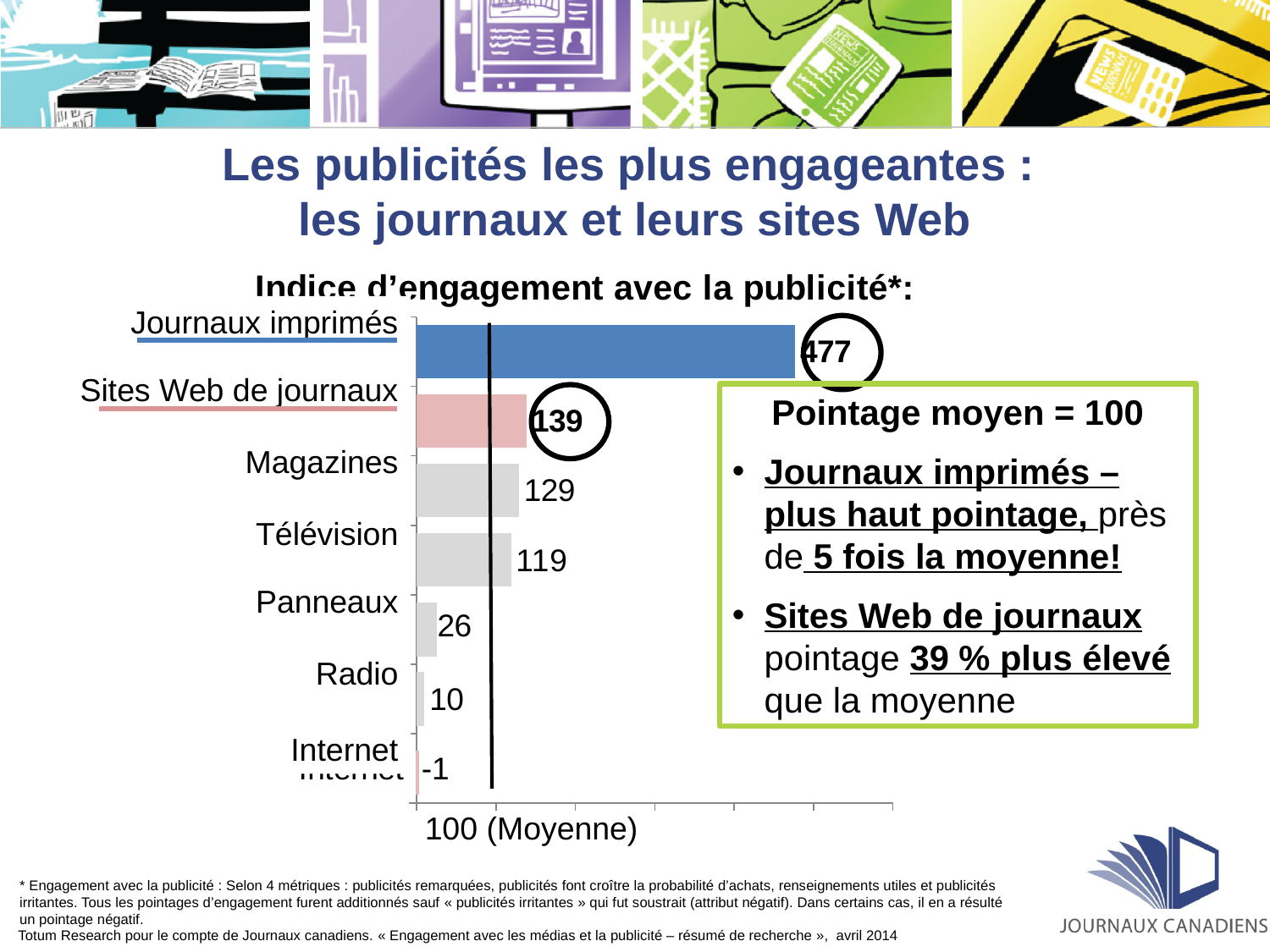
What is the value for Sites Web de journaux? 139 What kind of chart is shown on the slide? Bar chart What is the difference between the values for Magazines and Télévision? 10 What is the value for Télévision? 119 Which category has the lowest value? Internet Which category has the highest value? Journaux imprimés What is the value for Internet? -1 What is the difference between the values for Panneaux and Radio? 16 What is the value for Journaux imprimés? 477 How many categories are shown in the chart? 7 Which is larger, the value for Sites Web de journaux or the value for Magazines? Sites Web de journaux What value does the vertical reference line in the chart mark? 100 (Moyenne)